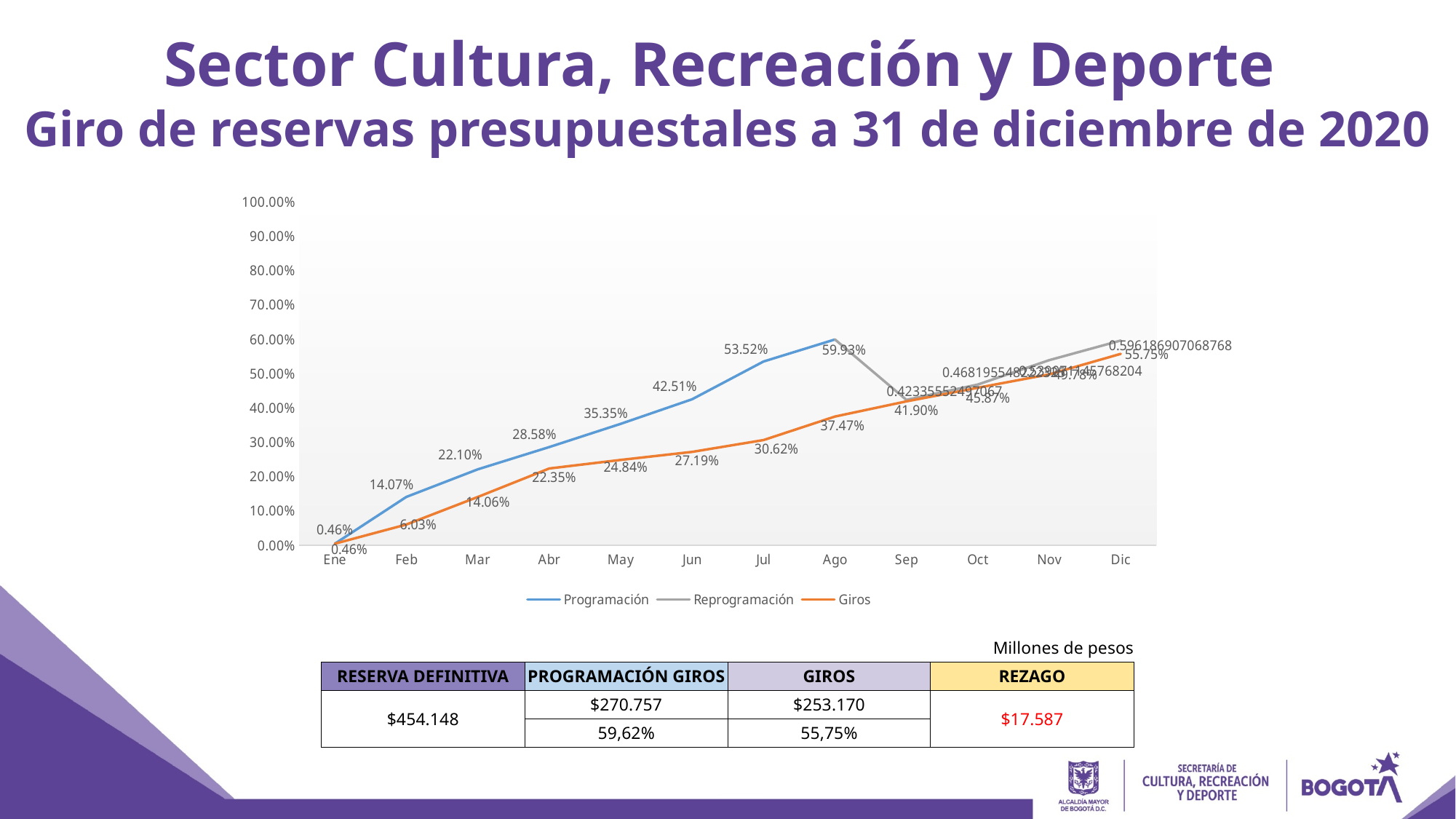
In which month does the Giros series reach its highest value? Dic What is the Reprogramación value labelled for Dic? 0.596186907068768 Which is larger in Feb, the Programación value or the Giros value? Programación Does the Giros series rise or fall from Ene to Dic? rise How many months are shown on the x axis of the chart? 12 What is the Programación value for Ago? 59.93% How many series does the chart legend list? 3 What is the Giros value for Abr? 22.35% What is the Programación value for Jul? 53.52% What kind of chart is shown on the slide? line chart What is the difference between the Programación and Giros values in Jun? 15.32% What is the Giros value for Dic? 55.75%